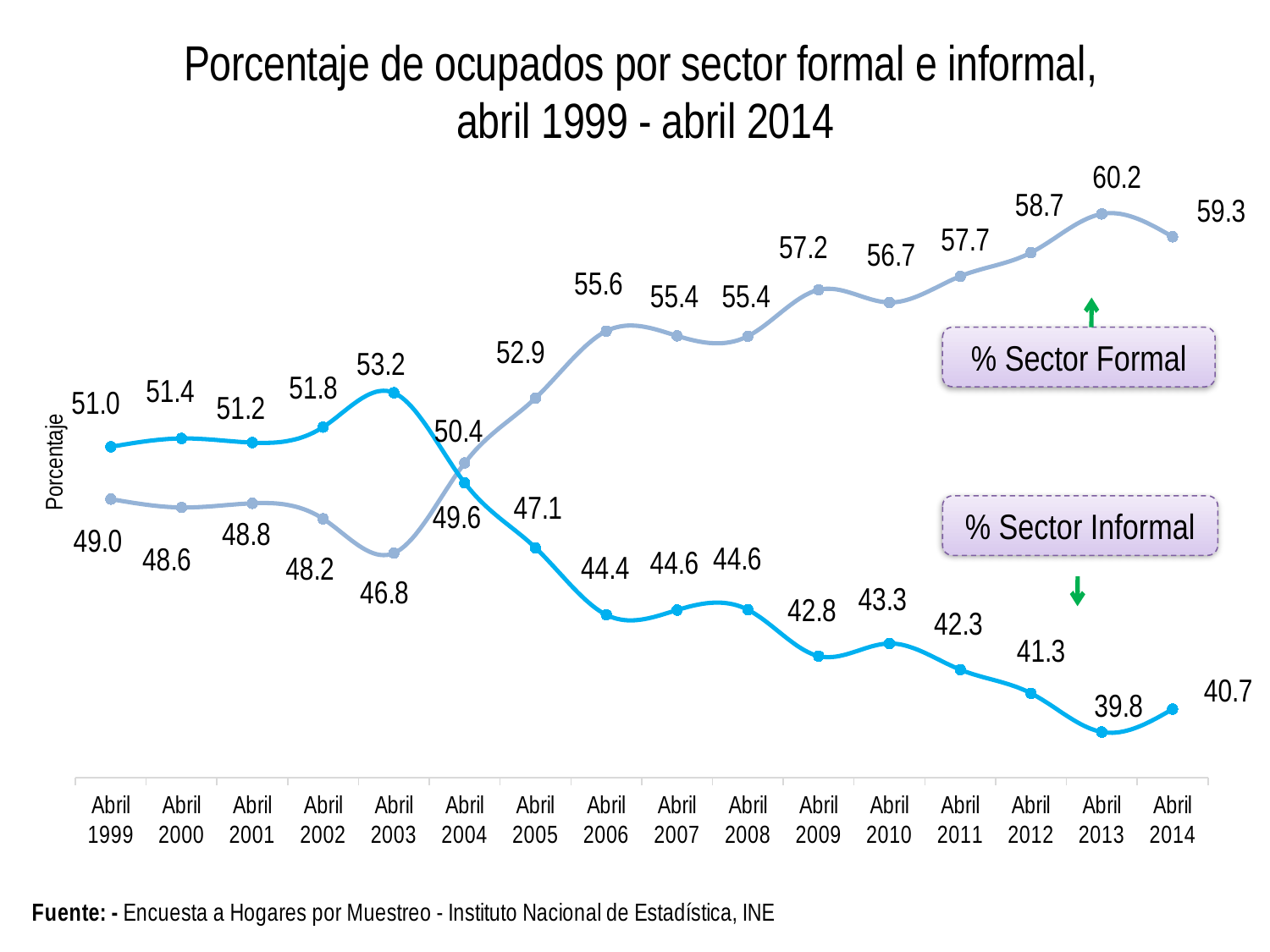
How many series are plotted on the chart? 2 What type of chart is shown on the slide? Line chart In which period does % Sector Formal reach its highest value? Abril 2013 Which is larger in Abril 2002, % Sector Formal or % Sector Informal? % Sector Informal Does % Sector Informal generally rise or fall from Abril 1999 to Abril 2014? Fall What is the value of % Sector Informal in Abril 1999? 51.0 What is the value of % Sector Formal in Abril 2003? 46.8 How many time periods are plotted on the x axis? 16 What is the difference between % Sector Formal and % Sector Informal in Abril 2014? 18.6 What is the label of the y axis? Porcentaje What is the value of % Sector Formal in Abril 2014? 59.3 In which period does % Sector Informal reach its lowest value? Abril 2013